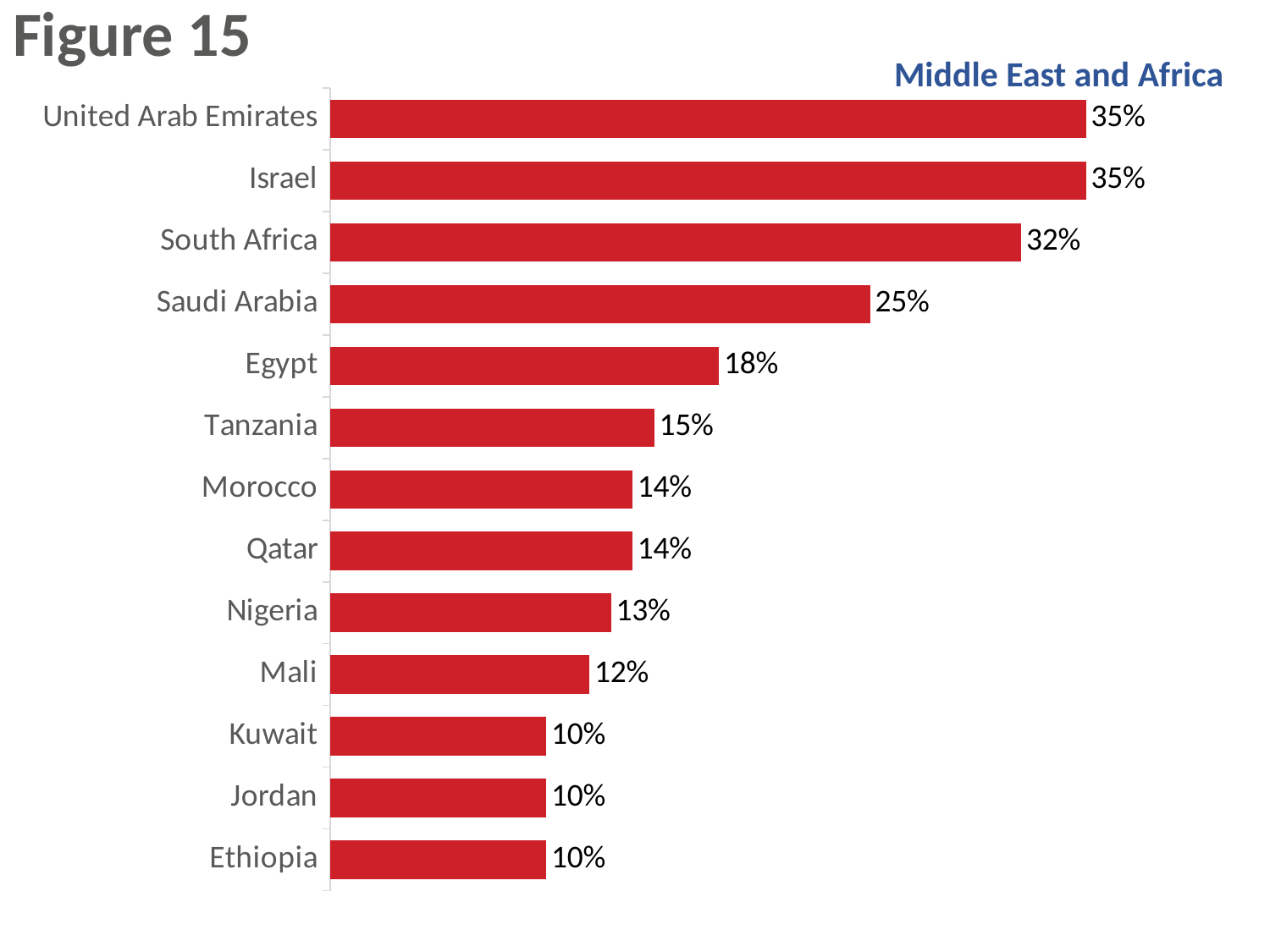
What is the title of the chart? Middle East and Africa Which is larger, the value for Egypt or the value for Saudi Arabia? Saudi Arabia Which is larger, the value for Morocco or the value for Mali? Morocco How many countries are shown in the chart? 13 What is the value for Nigeria? 13% Which country has the lowest value that is not tied with another country? Mali What is the difference between the values for Saudi Arabia and Tanzania? 10% What is the difference between the values for South Africa and Egypt? 14% What is the value for Egypt? 18% What is the value for Saudi Arabia? 25% What is the value for South Africa? 32% What kind of chart is shown on the slide? Bar chart